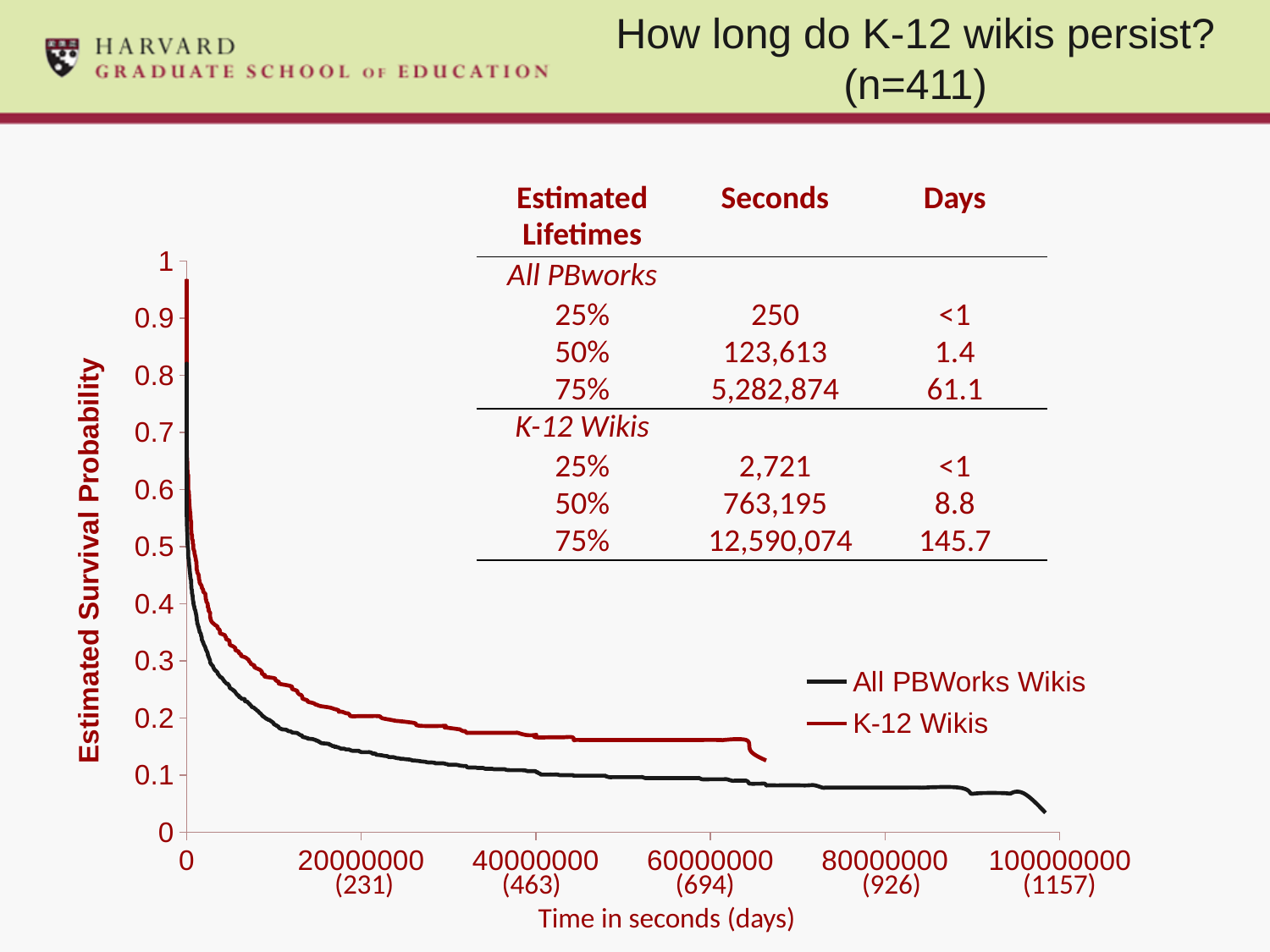
Is the survival probability for All PBWorks Wikis at 20000000 seconds greater or less than 0.2? less Is the survival probability for All PBWorks Wikis at 80000000 seconds greater or less than 0.1? less How many labelled tick marks are on the chart's x axis? 6 Is the survival probability for K-12 Wikis at 60000000 seconds greater or less than 0.2? less Which series extends further along the x axis, All PBWorks Wikis or K-12 Wikis? All PBWorks Wikis How many series does the chart's legend list? 2 What is the label of the chart's y axis? Estimated Survival Probability Do the survival probability curves rise or fall as time increases along the x axis? fall What kind of chart is shown on the slide? line chart Which series has the higher survival probability at 40000000 seconds, All PBWorks Wikis or K-12 Wikis? K-12 Wikis Which two series are listed in the chart's legend? All PBWorks Wikis and K-12 Wikis